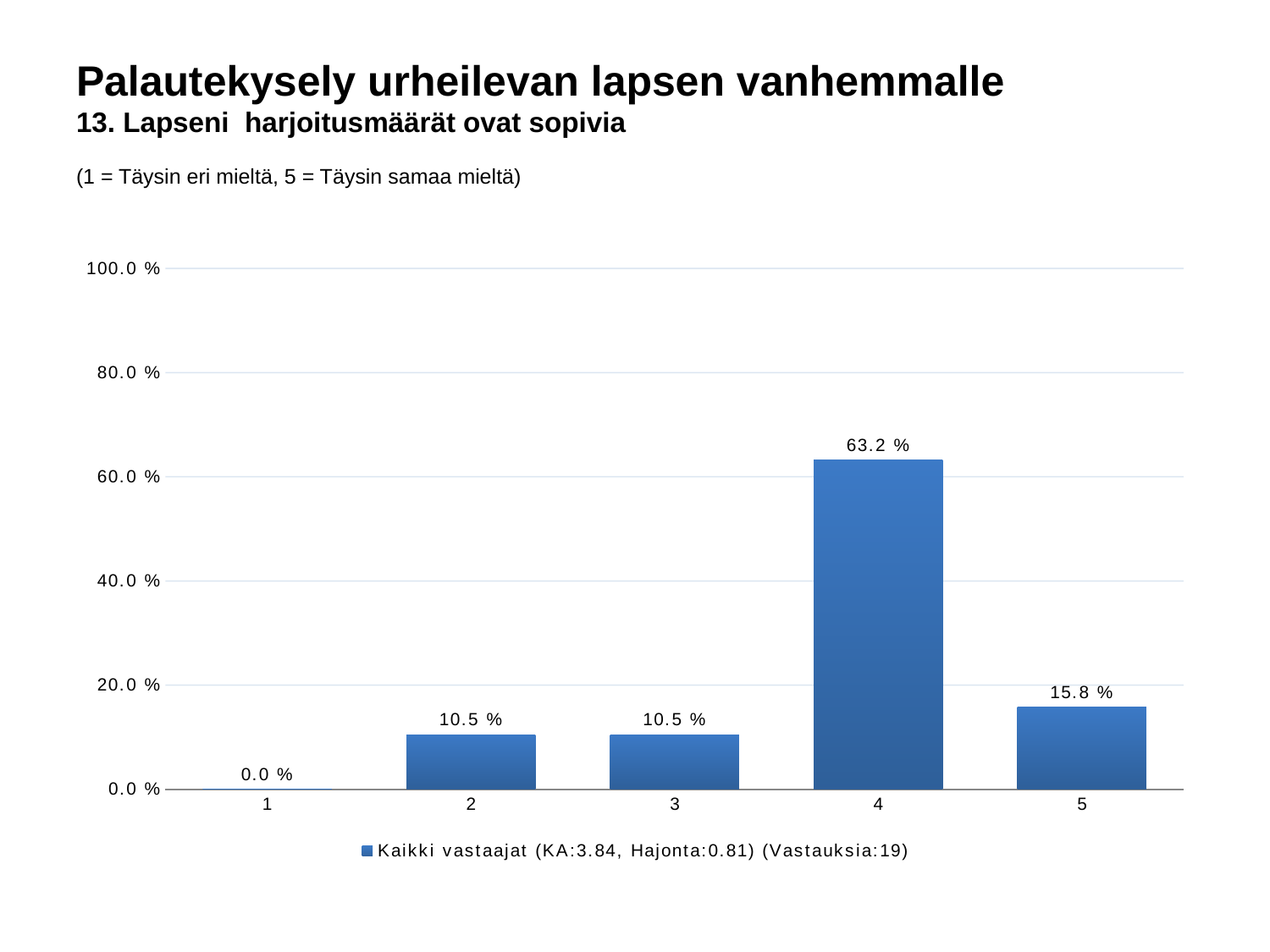
What kind of chart is shown? bar chart What is the difference between the values for category 4 and category 5? 47.4 % How many series does the legend list? 1 Is the value for category 4 greater or less than 60.0 %? greater What is the value for category 1? 0.0 % How many categories are shown on the x axis? 5 How many responses (Vastauksia) does the legend report? 19 Which category has the lowest value? 1 Which category has the highest value? 4 Which is larger, the value for category 5 or the value for category 2? 5 What is the value for category 5? 15.8 % What is the value for category 4? 63.2 %